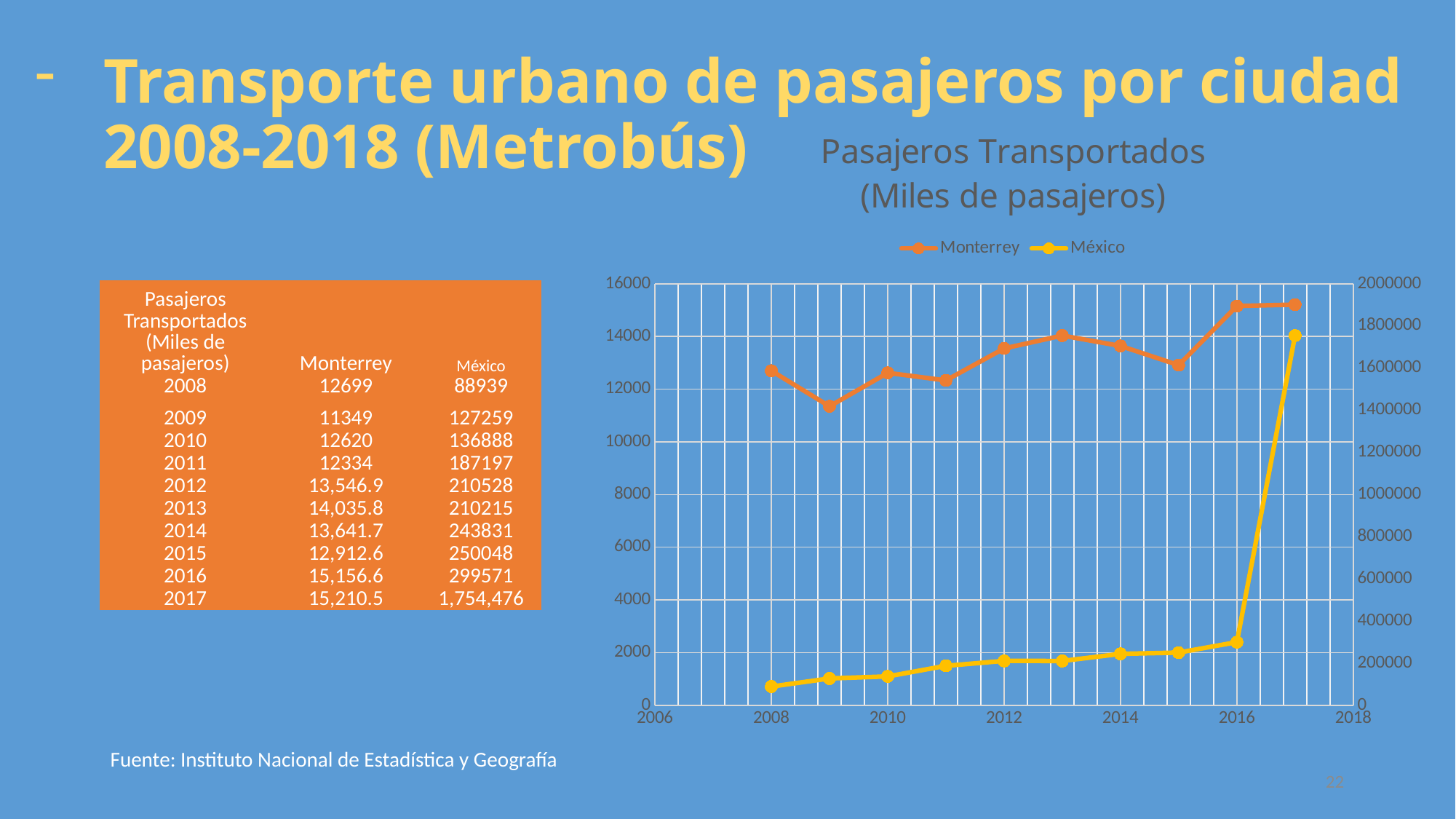
What is the difference between the Monterrey values for 2008 and 2009? 1350 In which year is the México series at its highest? 2017 How many series does the chart legend list? 2 How many years of data are plotted for each series in the chart? 10 Which is larger for Monterrey, the value in 2013 or the value in 2015? 2013 What is the value for México in 2008? 88939 In which year is the Monterrey series at its lowest? 2009 What is the value for Monterrey in 2017? 15,210.5 What kind of chart is shown on the slide? line chart What colour is the Monterrey line in the chart? orange Does the México series generally rise or fall from 2008 to 2017? rise Is the Monterrey value for 2012 greater or less than 12000? greater